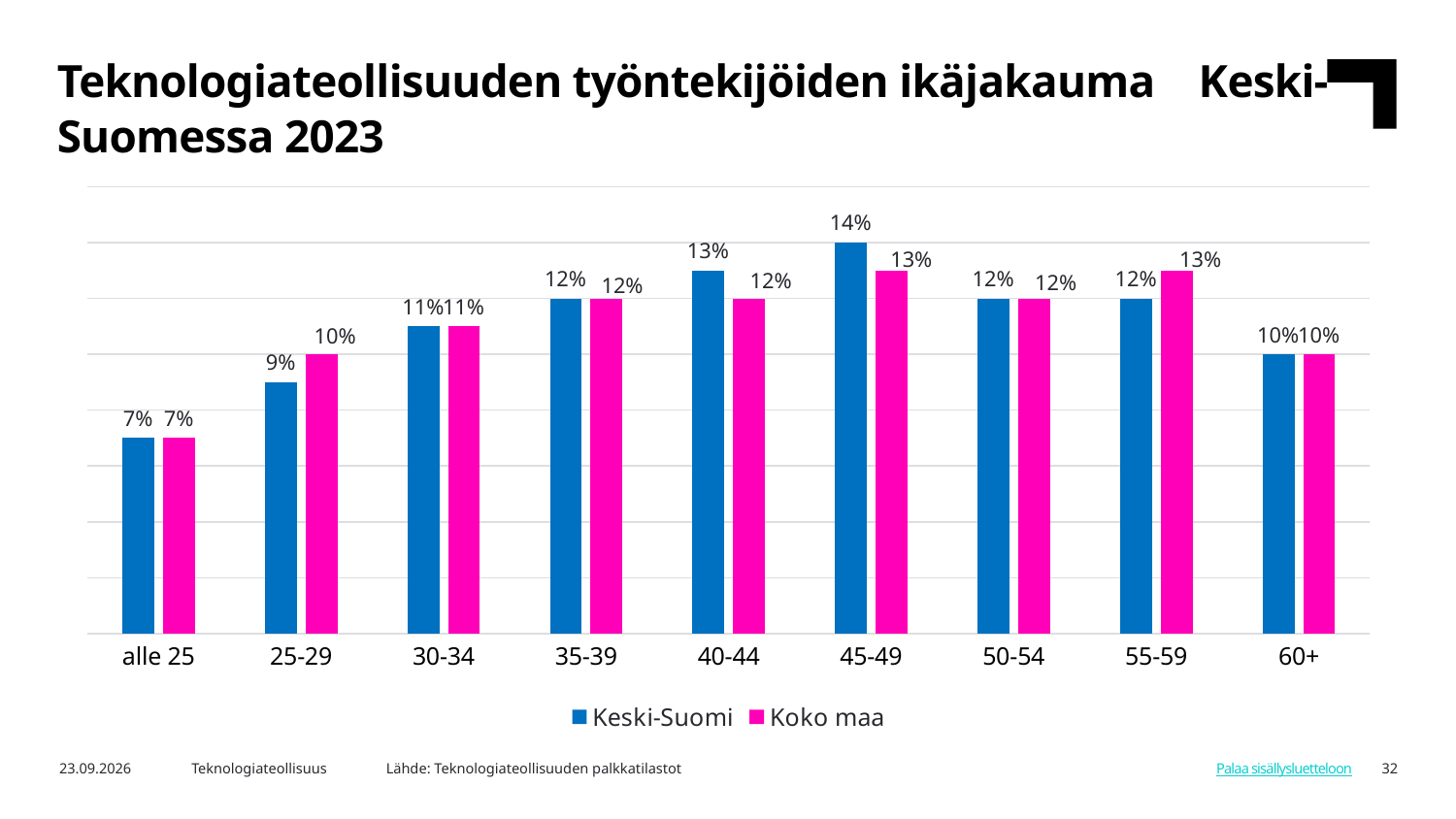
What is the Koko maa value for the 25-29 age group? 10% Which age group has the lowest Koko maa value? alle 25 What is the Keski-Suomi value for the 40-44 age group? 13% For the 40-44 age group, which is larger: the Keski-Suomi value or the Koko maa value? Keski-Suomi Which age group has the highest Keski-Suomi value? 45-49 What type of chart is shown on the slide? Bar chart What is the difference between the Keski-Suomi and Koko maa values for the 25-29 age group? 1% How many age categories are shown on the x axis? 9 Which series is shown in pink in the legend? Koko maa How many series does the legend list? 2 What is the difference between the Keski-Suomi values for the 45-49 and alle 25 age groups? 7% What is the Keski-Suomi value for the 45-49 age group? 14%